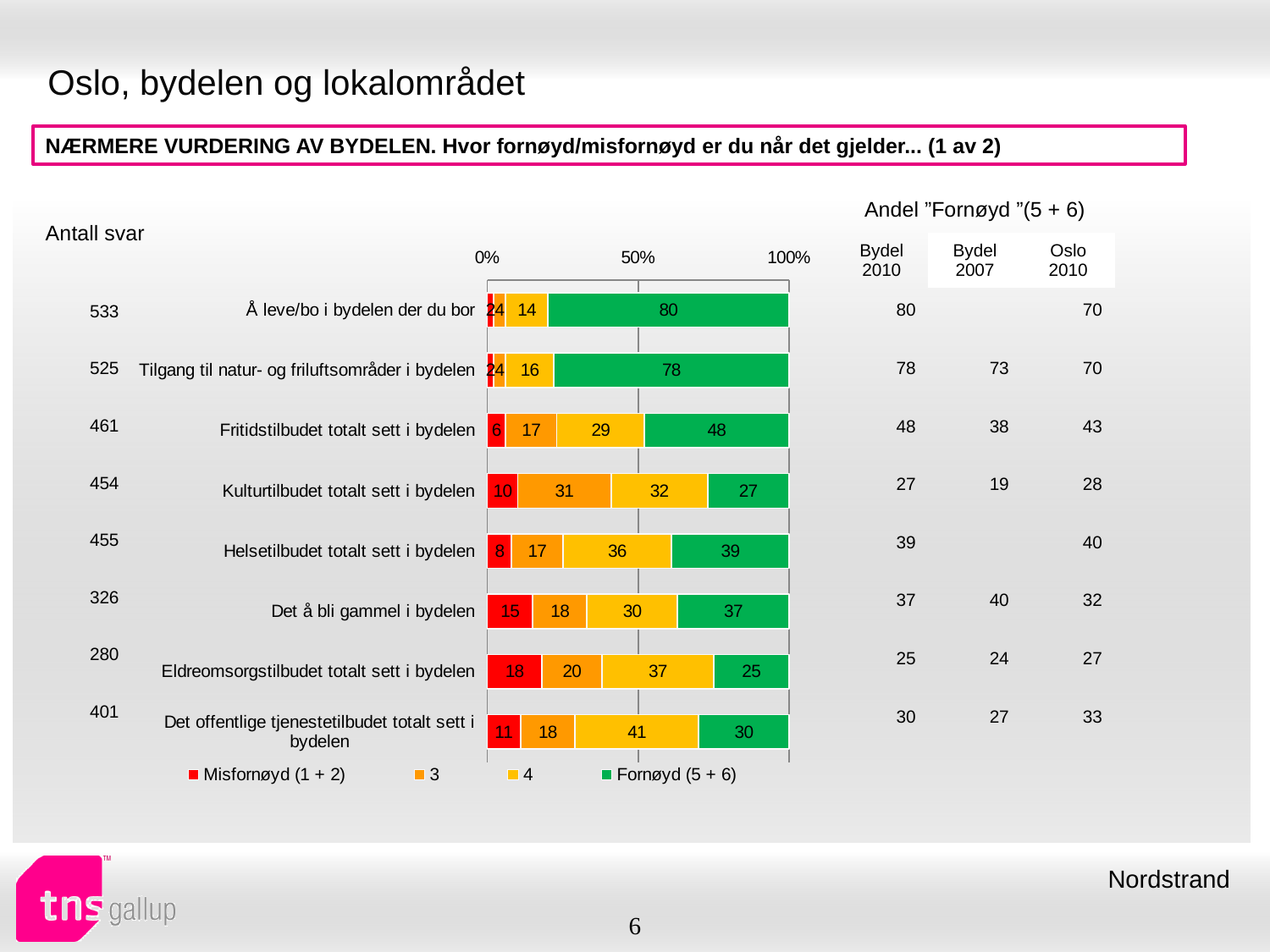
How many categories are shown in the bar chart? 8 How many series does the legend list? 4 What is the value of the Fornøyd (5 + 6) segment for Fritidstilbudet totalt sett i bydelen? 48 Which category has the lowest Fornøyd (5 + 6) value? Eldreomsorgstilbudet totalt sett i bydelen What is the value of the '3' segment for Det å bli gammel i bydelen? 18 Which has the larger '4' segment: Kulturtilbudet totalt sett i bydelen or Helsetilbudet totalt sett i bydelen? Helsetilbudet totalt sett i bydelen What is the value of the Misfornøyd (1 + 2) segment for Eldreomsorgstilbudet totalt sett i bydelen? 18 Which category has the highest Fornøyd (5 + 6) value? Å leve/bo i bydelen der du bor What kind of chart is shown on the slide? Stacked bar chart How much larger is the Fornøyd (5 + 6) value for Fritidstilbudet totalt sett i bydelen than for Kulturtilbudet totalt sett i bydelen? 21 What is the first entry in the chart's legend? Misfornøyd (1 + 2) What is the total of the stacked bar for Kulturtilbudet totalt sett i bydelen? 100